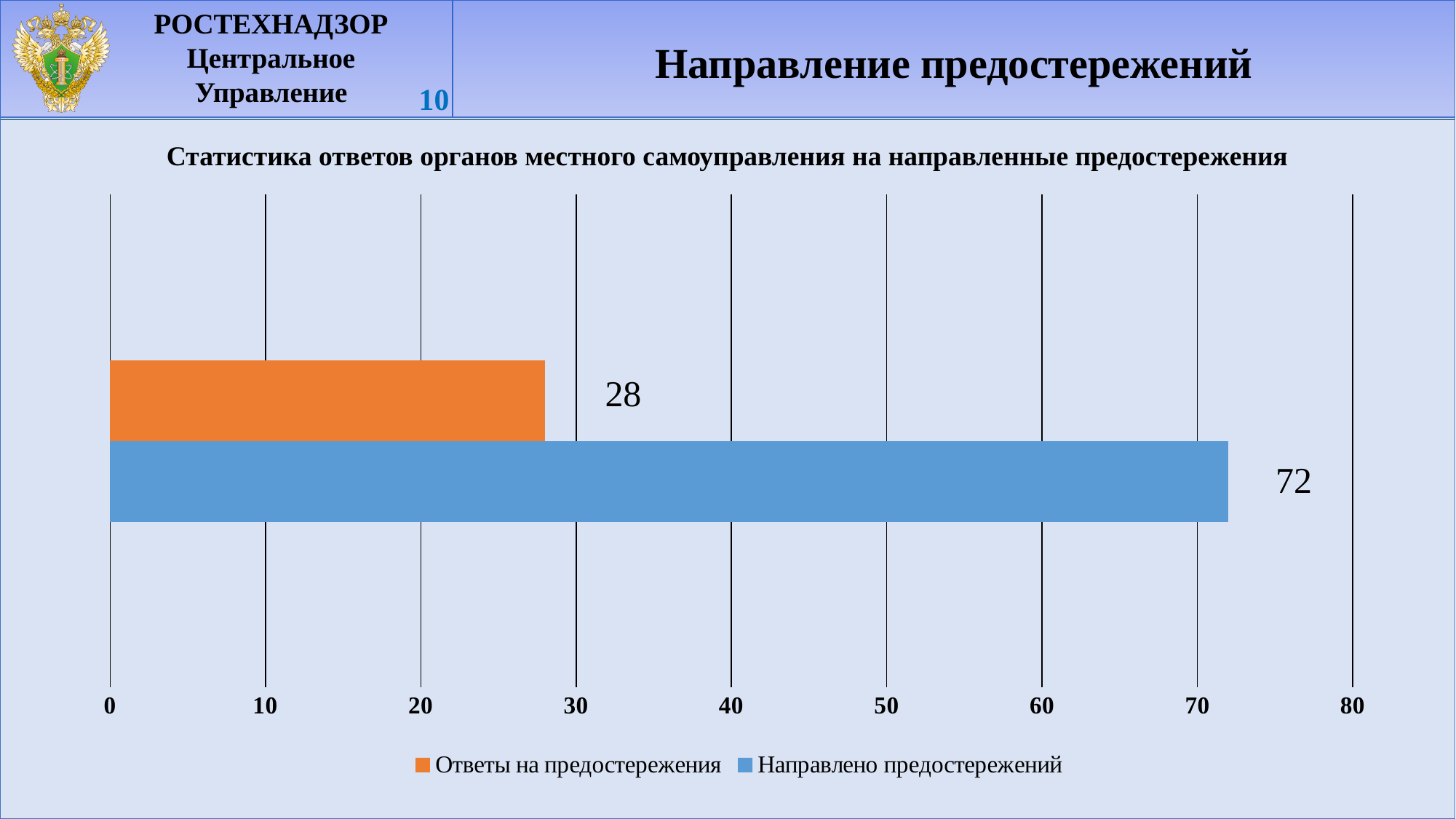
What kind of chart is shown on the slide? Bar chart How many series does the legend list? 2 What is the value for "Ответы на предостережения"? 28 Is the value for "Направлено предостережений" greater or less than 70? greater What colour is the bar for "Ответы на предостережения"? Orange What is the difference between "Направлено предостережений" and "Ответы на предостережения"? 44 What is the maximum value shown on the horizontal axis? 80 Is the value for "Ответы на предостережения" greater or less than 30? less What is the title of the chart? Статистика ответов органов местного самоуправления на направленные предостережения What is the value for "Направлено предостережений"? 72 Which series has the higher value, "Ответы на предостережения" or "Направлено предостережений"? Направлено предостережений